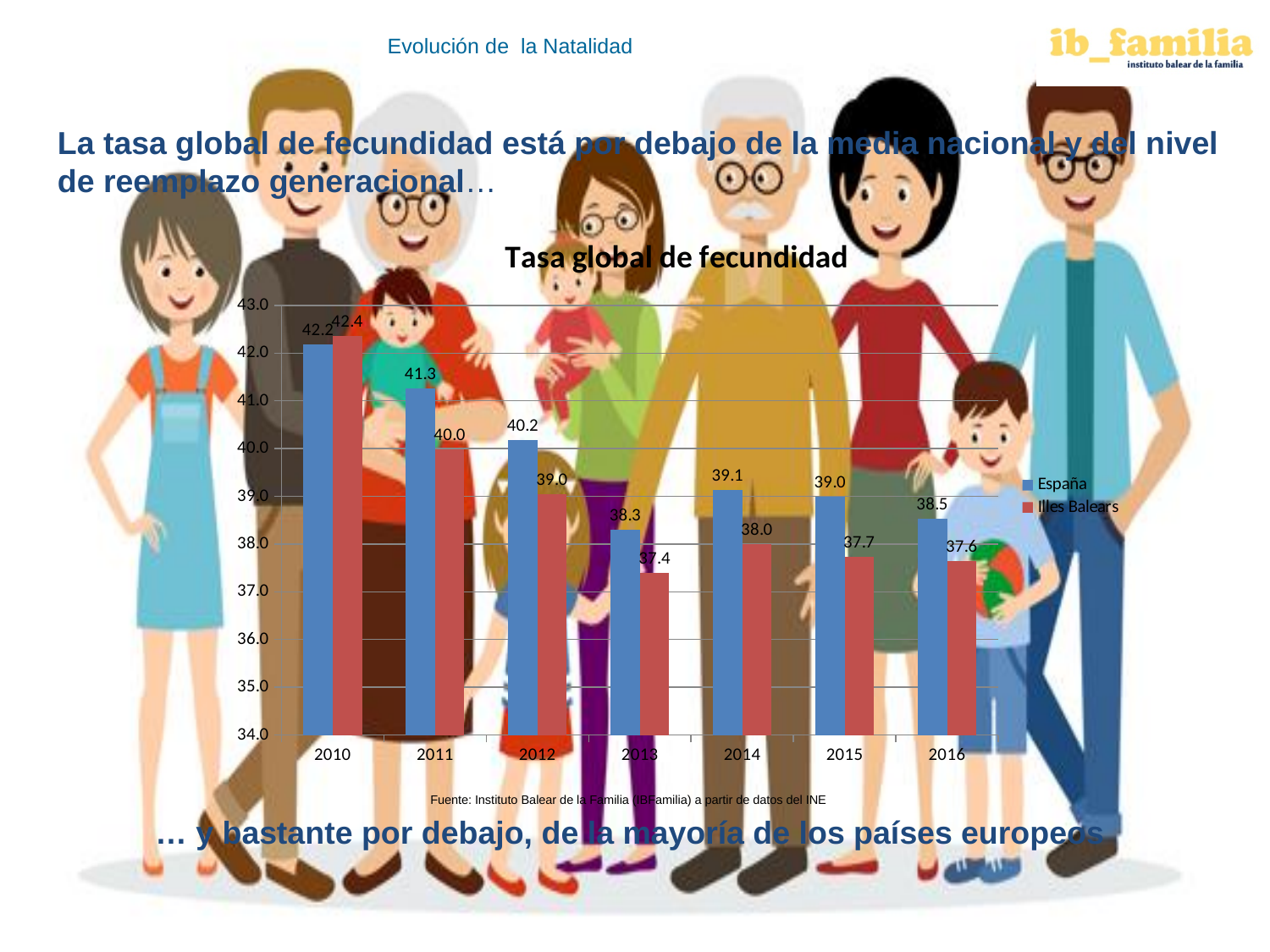
Which colour represents Illes Balears in the 'Tasa global de fecundidad' chart? Red Is the España value for 2014 greater or less than 39.0 in the 'Tasa global de fecundidad' chart? greater What kind of chart is the 'Tasa global de fecundidad' chart? Bar chart How many years are shown on the x axis of the 'Tasa global de fecundidad' chart? 7 In which year is the España value highest in the 'Tasa global de fecundidad' chart? 2010 What is the difference between the España and Illes Balears values in 2015 in the 'Tasa global de fecundidad' chart? 1.3 What is the value for Illes Balears in 2013 in the 'Tasa global de fecundidad' chart? 37.4 In which year is the Illes Balears value lowest in the 'Tasa global de fecundidad' chart? 2013 What is the value for Illes Balears in 2016 in the 'Tasa global de fecundidad' chart? 37.6 In 2010, which is larger in the 'Tasa global de fecundidad' chart: España or Illes Balears? Illes Balears How many series does the legend of the 'Tasa global de fecundidad' chart list? 2 What is the value for España in 2011 in the 'Tasa global de fecundidad' chart? 41.3